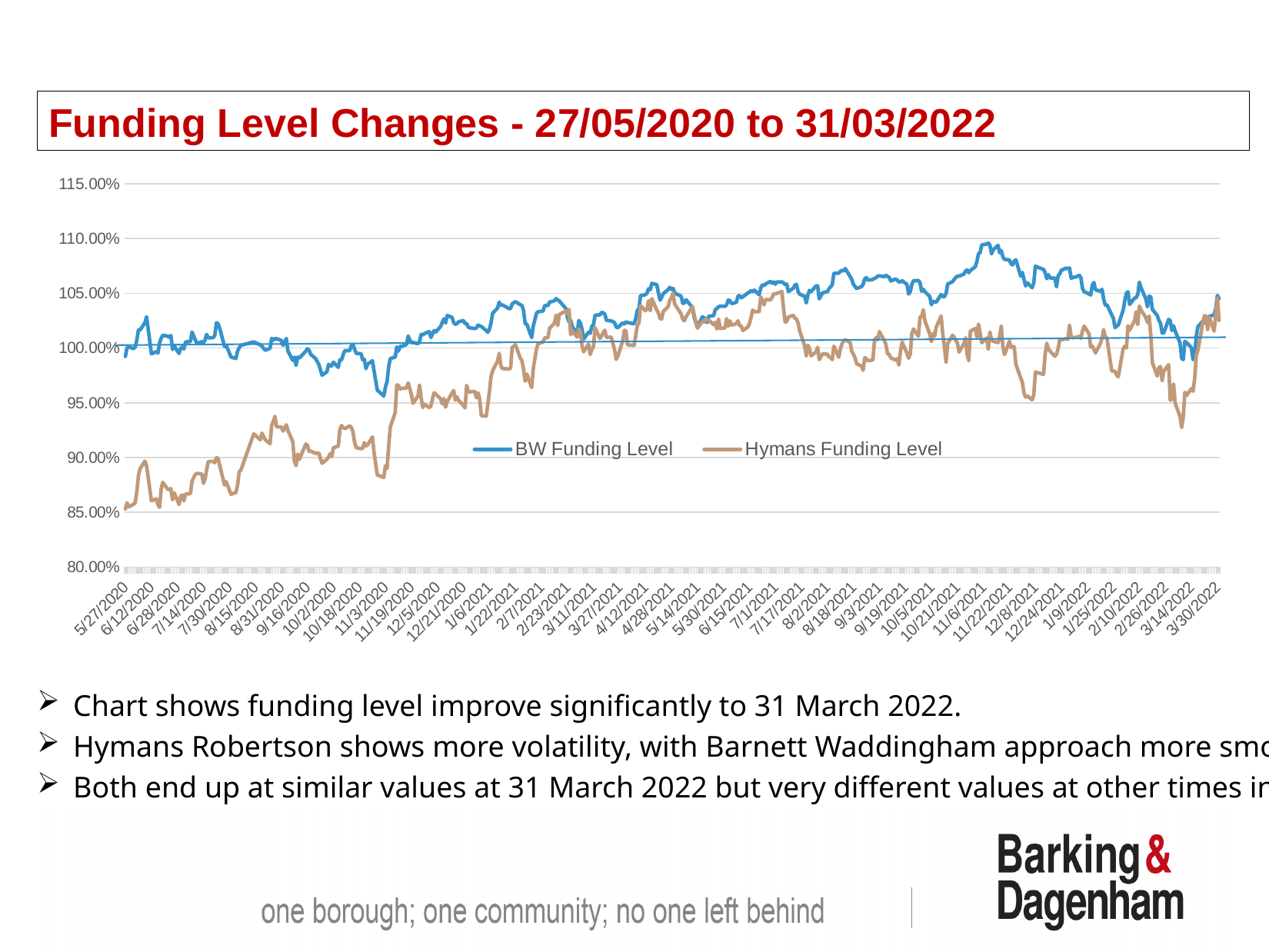
Is the BW Funding Level at 11/3/2020 greater or less than 100.00%? less What is the title of the slide containing the chart? Funding Level Changes - 27/05/2020 to 31/03/2022 Is the Hymans Funding Level at 5/27/2020 greater or less than 90.00%? less Is the highest point of the BW Funding Level (around 11/6/2021) greater or less than 105.00%? greater Does the Hymans Funding Level overall rise or fall from 5/27/2020 to 3/30/2022? Rise What is the highest value shown on the chart's vertical axis? 115.00% At 5/27/2020, which series has the higher funding level, BW Funding Level or Hymans Funding Level? BW Funding Level Which series shows the lowest value anywhere on the chart? Hymans Funding Level What are the two series named in the chart legend? BW Funding Level and Hymans Funding Level How many series does the chart legend list? 2 What kind of chart is shown on the slide? Line chart